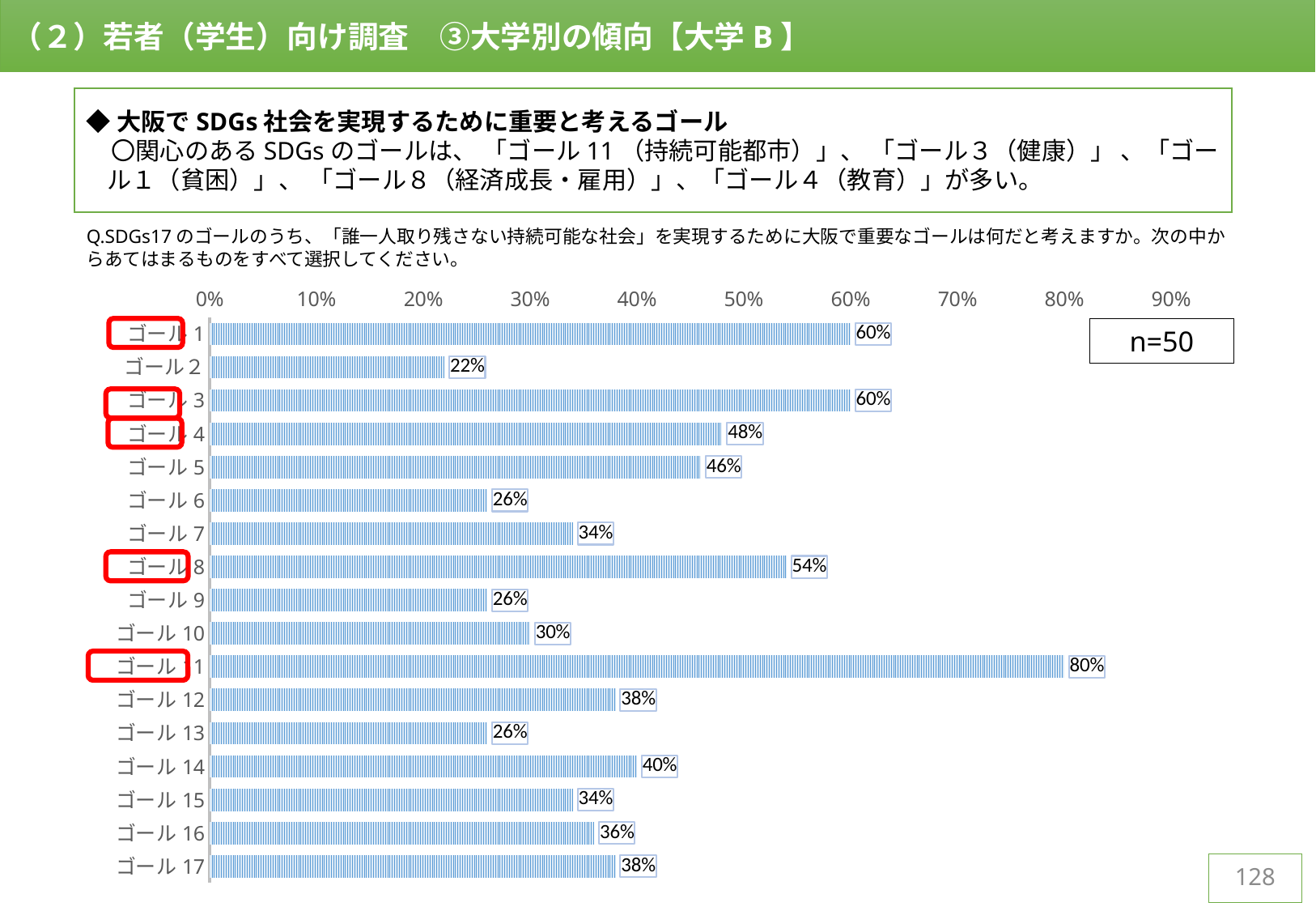
What is the difference between the values for ゴール 4 and ゴール 5? 2% What kind of chart is shown on the slide? bar chart What sample size (n) is shown next to the chart? n=50 How many goals (categories) are shown in the chart? 17 Which goal has the lowest value? ゴール 2 What is the value for ゴール 2? 22% What is the value for ゴール 11? 80% Is the value for ゴール 8 greater or less than 50%? greater Which goal has the highest value? ゴール 11 Which is larger, the value for ゴール 14 or the value for ゴール 7? ゴール 14 What is the value for ゴール 8? 54% What is the difference between the values for ゴール 11 and ゴール 1? 20%